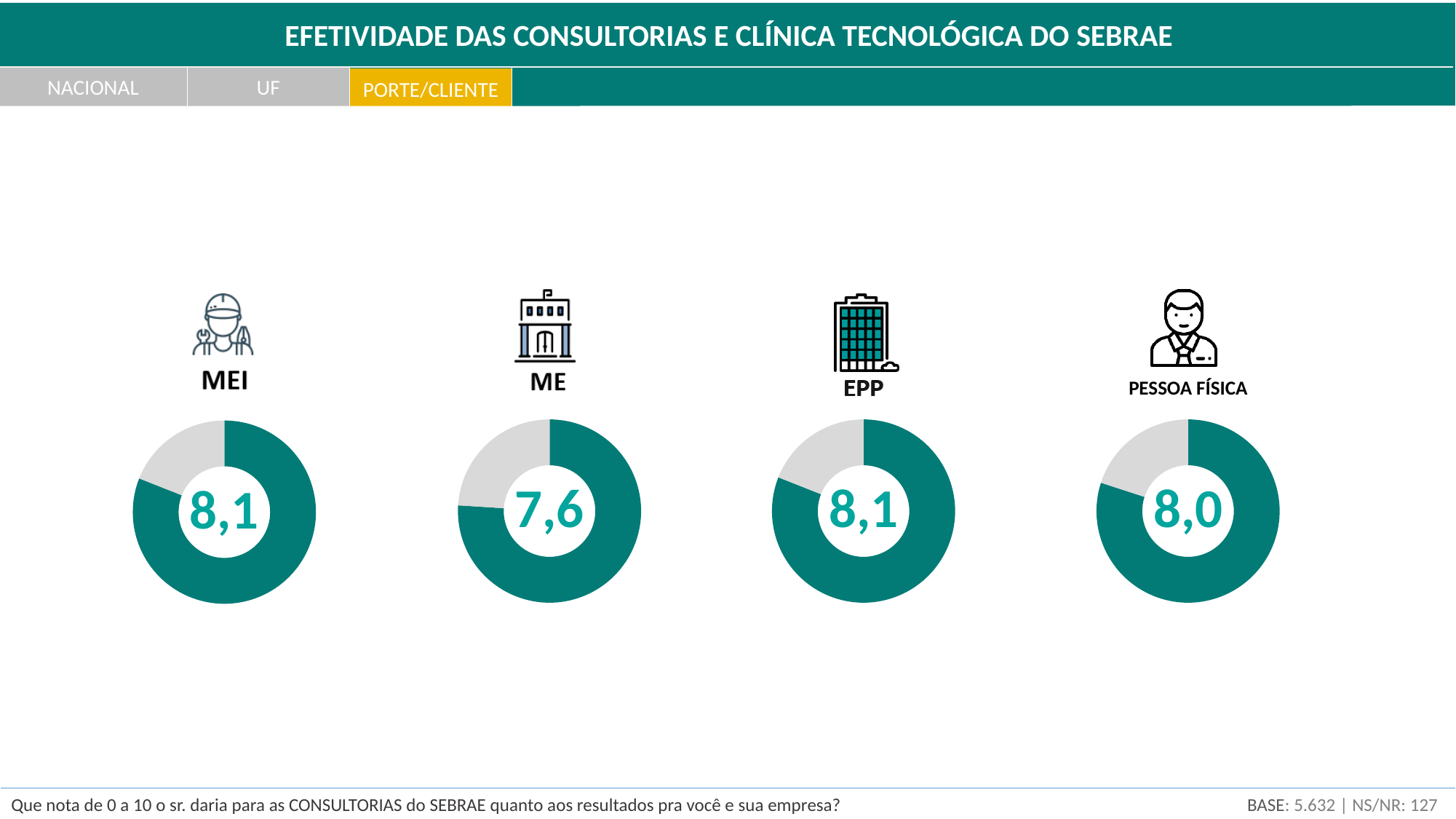
What is the difference between the EPP score and the PESSOA FÍSICA score? 0,1 Which group has the lowest score among the four donut charts? ME What kind of chart is used to display each group's score? Donut (pie) chart Which tab is highlighted in yellow at the top of the slide? PORTE/CLIENTE What score is shown in the MEI donut chart? 8,1 What score is shown in the EPP donut chart? 8,1 Which has a higher score, ME or PESSOA FÍSICA? PESSOA FÍSICA What score is shown in the ME donut chart? 7,6 Which groups share the highest score among the four donut charts? MEI and EPP How many donut charts are shown on the slide? 4 What score is shown in the PESSOA FÍSICA donut chart? 8,0 What is the difference between the MEI score and the ME score? 0,5